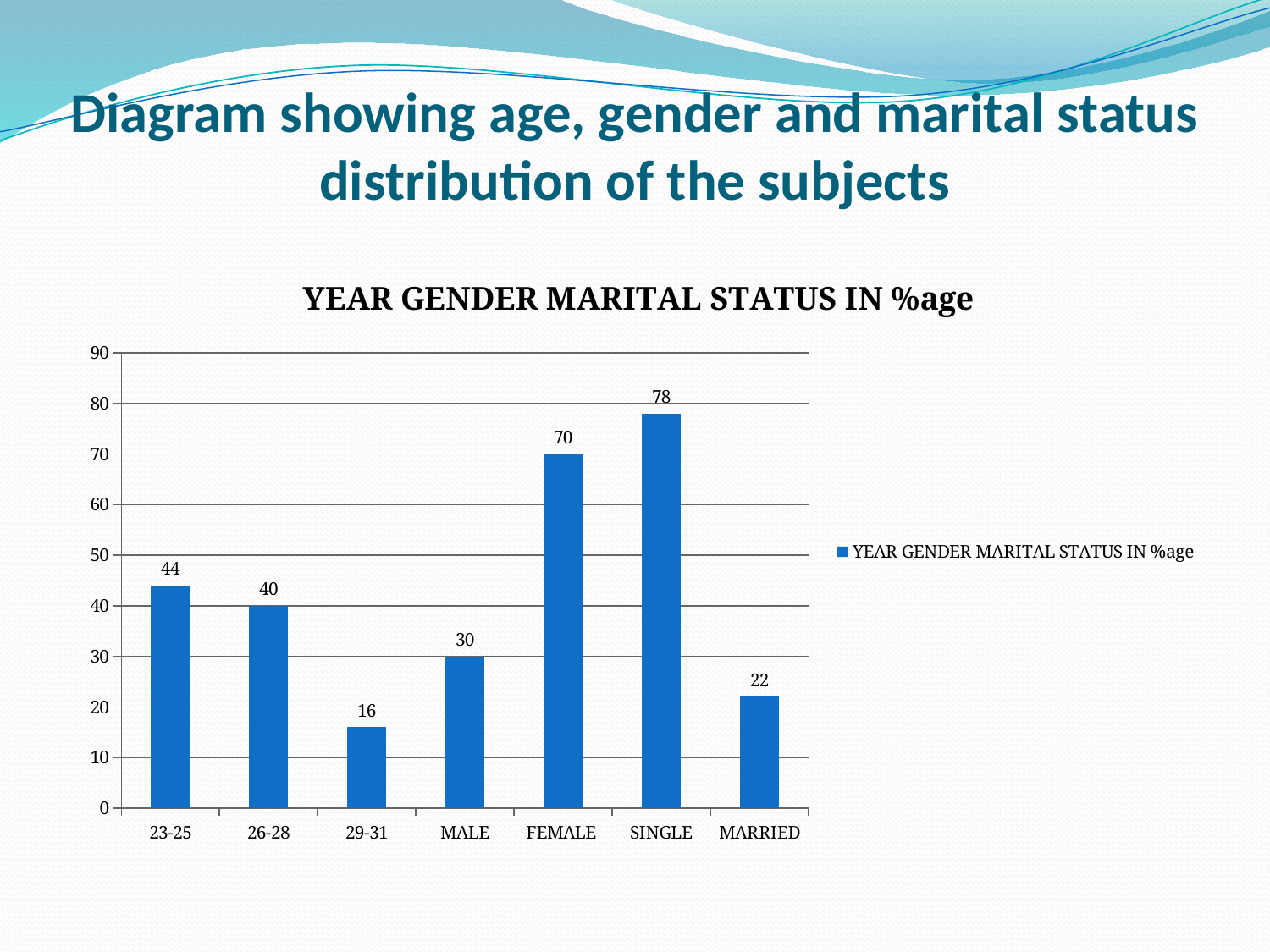
What is the value for FEMALE? 70 What is the value for MARRIED? 22 Is the value for SINGLE greater or less than 80? less What is the difference between the values for FEMALE and MALE? 40 What is the value for the 29-31 age group? 16 What is the difference between the values for SINGLE and MARRIED? 56 Which category has the highest value? SINGLE How many categories are shown on the x axis? 7 What kind of chart is shown on the slide? bar chart What is the title of the chart? YEAR GENDER MARITAL STATUS IN %age Which is larger, the value for 23-25 or the value for 26-28? 23-25 Which category has the lowest value? 29-31